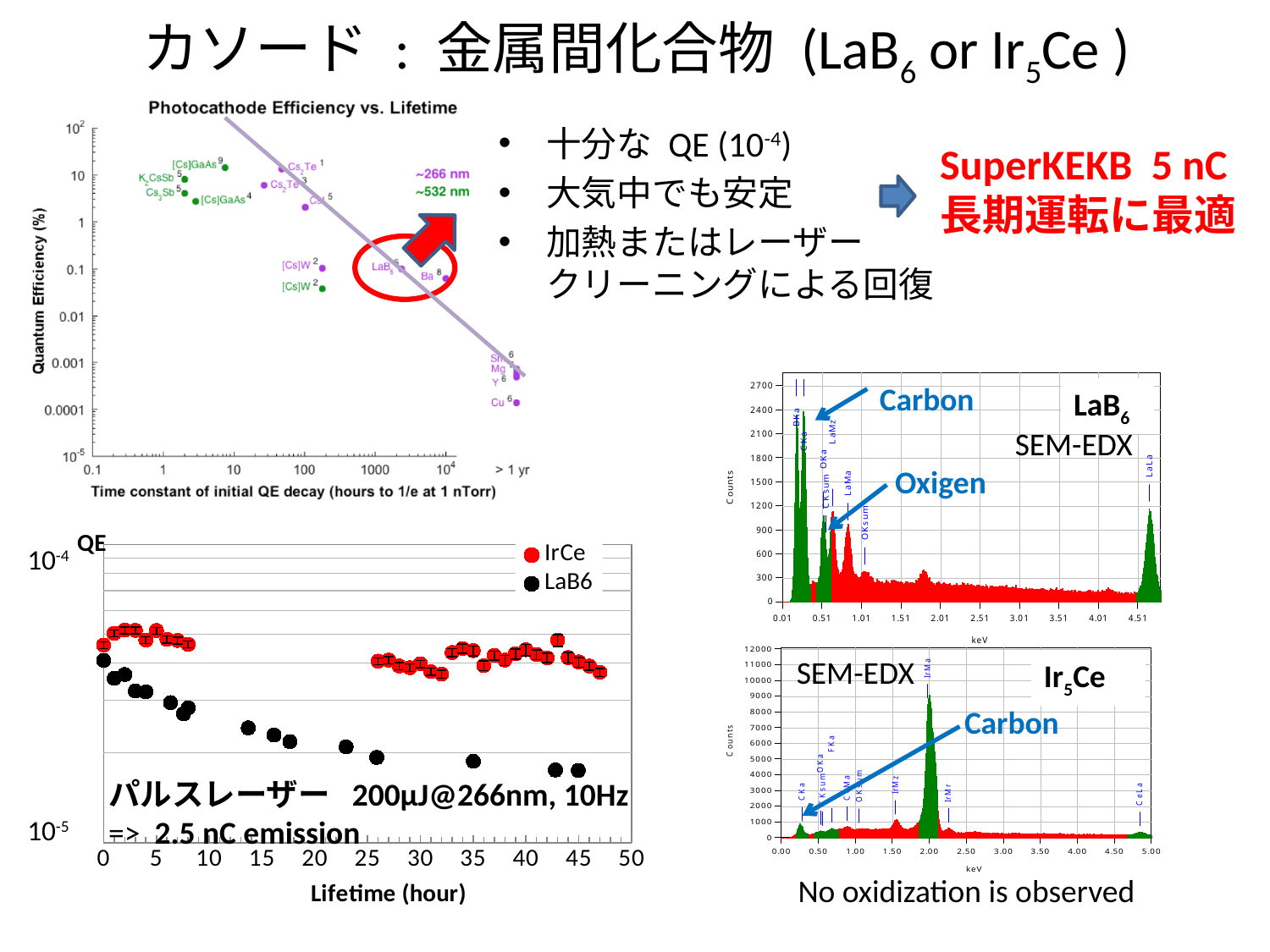
In the bottom-left chart (QE vs Lifetime), what are the two series named in the legend? IrCe and LaB6 In the LaB6 SEM-EDX chart, is the highest peak count greater or less than 1800? greater In the top-left chart (Photocathode Efficiency vs. Lifetime), which material has the lowest quantum efficiency? Cu In the bottom-left chart (QE vs Lifetime), how many series does the legend list? 2 In the bottom-left chart (QE vs Lifetime), does the QE of LaB6 rise or fall as lifetime increases? fall What kind of chart is the top-left chart (Photocathode Efficiency vs. Lifetime)? scatter chart In the Ir5Ce SEM-EDX chart, is the peak count of the IrMa line greater or less than 8000? greater In the top-left chart (Photocathode Efficiency vs. Lifetime), is the quantum efficiency of Cu greater or less than 0.001%? less In the bottom-left chart (QE vs Lifetime), what is the x-axis label? Lifetime (hour) In the bottom-left chart (QE vs Lifetime), which series has the higher QE at around 45 hours, IrCe or LaB6? IrCe What is the title of the top-left chart? Photocathode Efficiency vs. Lifetime